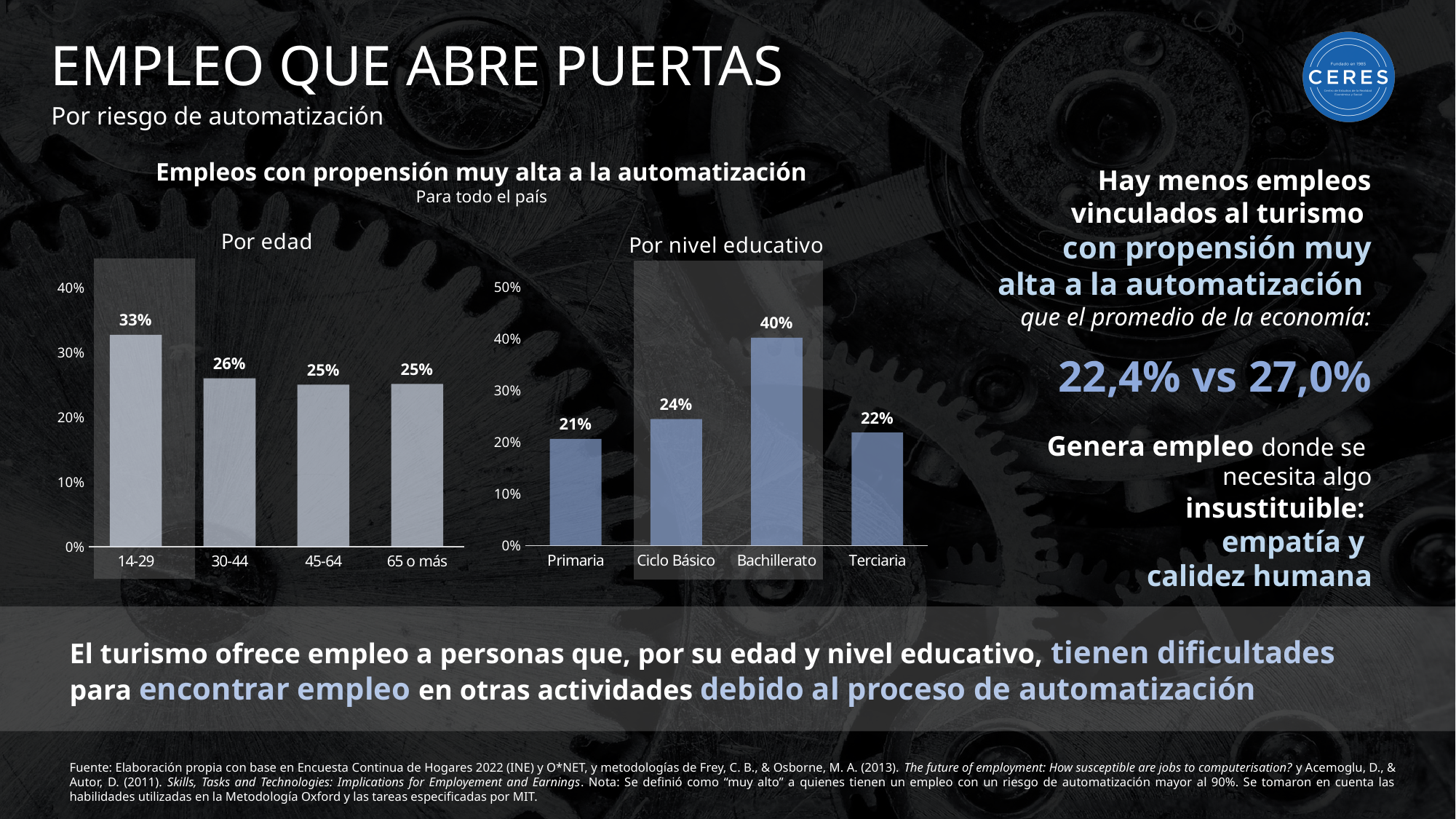
In the 'Por nivel educativo' chart, what is the difference between the Bachillerato and Terciaria values? 18% In the 'Por edad' chart, what is the value for the 14-29 age group? 33% In the 'Por nivel educativo' chart, which education level has the lowest value? Primaria In the 'Por edad' chart, which age group has the highest value? 14-29 In the 'Por nivel educativo' chart, what is the value for Primaria? 21% In the 'Por nivel educativo' chart, which is larger, the value for Ciclo Básico or Terciaria? Ciclo Básico In the 'Por edad' chart, what is the value for the 30-44 age group? 26% In the 'Por edad' chart, how many age categories are shown? 4 What kind of chart is the 'Por edad' chart? Bar chart In the 'Por nivel educativo' chart, what is the value for Bachillerato? 40% What is the main title shared by the two charts on the slide? Empleos con propensión muy alta a la automatización In the 'Por edad' chart, what is the difference between the 14-29 and 30-44 values? 7%